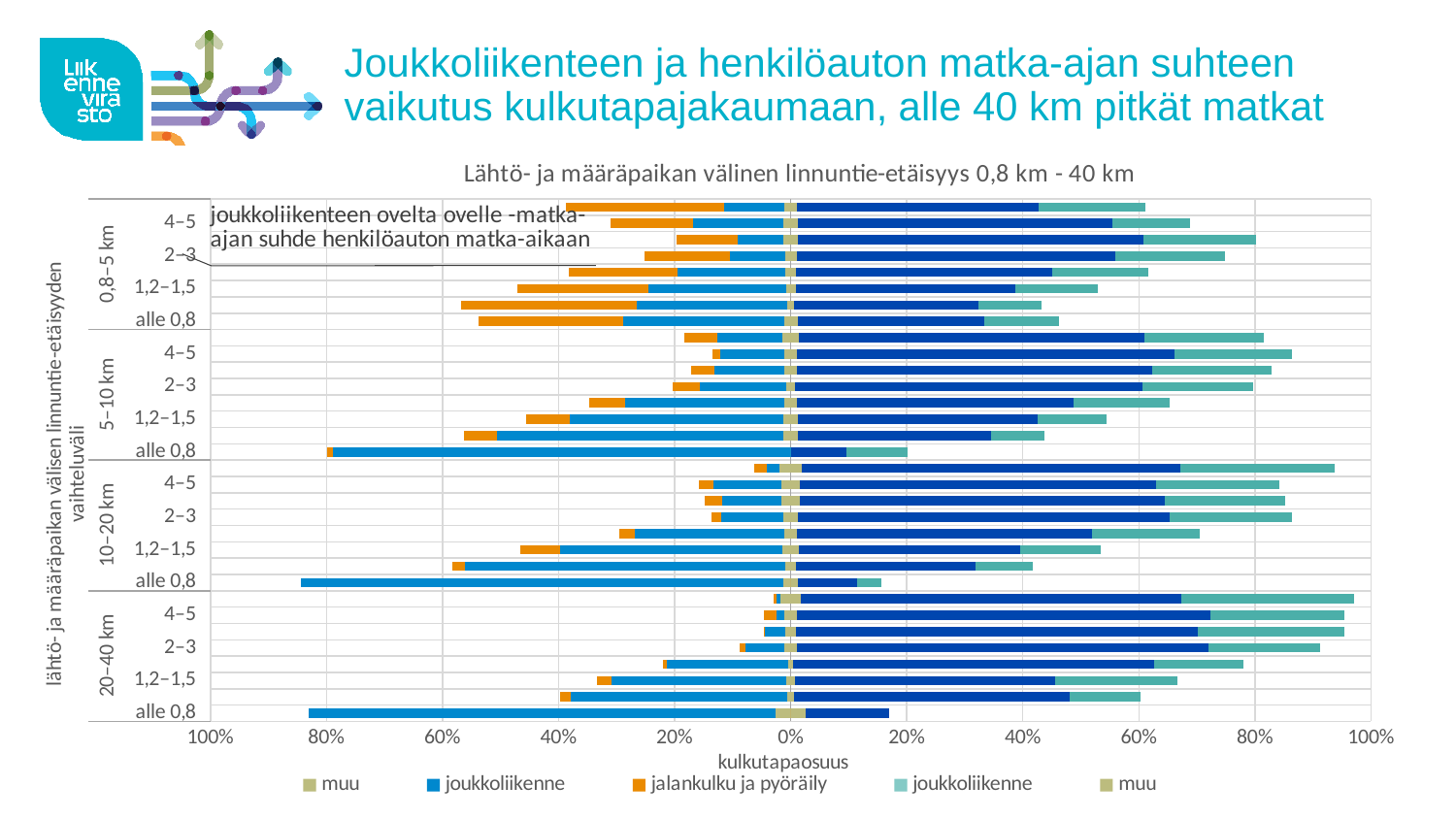
What is the title of the chart? Lähtö- ja määräpaikan välinen linnuntie-etäisyys 0,8 km - 40 km In the 5–10 km group, is the left-side (blue) value for 'alle 0,8' greater or less than 60%? greater In the 0,8–5 km group, is the right-side bar for 'alle 0,8' greater or less than 60%? less What kind of chart is shown on the slide? bar chart How many series does the legend list? 5 In the 10–20 km group, is the left-side (blue) value for 'alle 0,8' greater or less than 80%? greater What is the label of the horizontal axis? kulkutapaosuus How many distance groups (km ranges) are shown on the vertical axis? 4